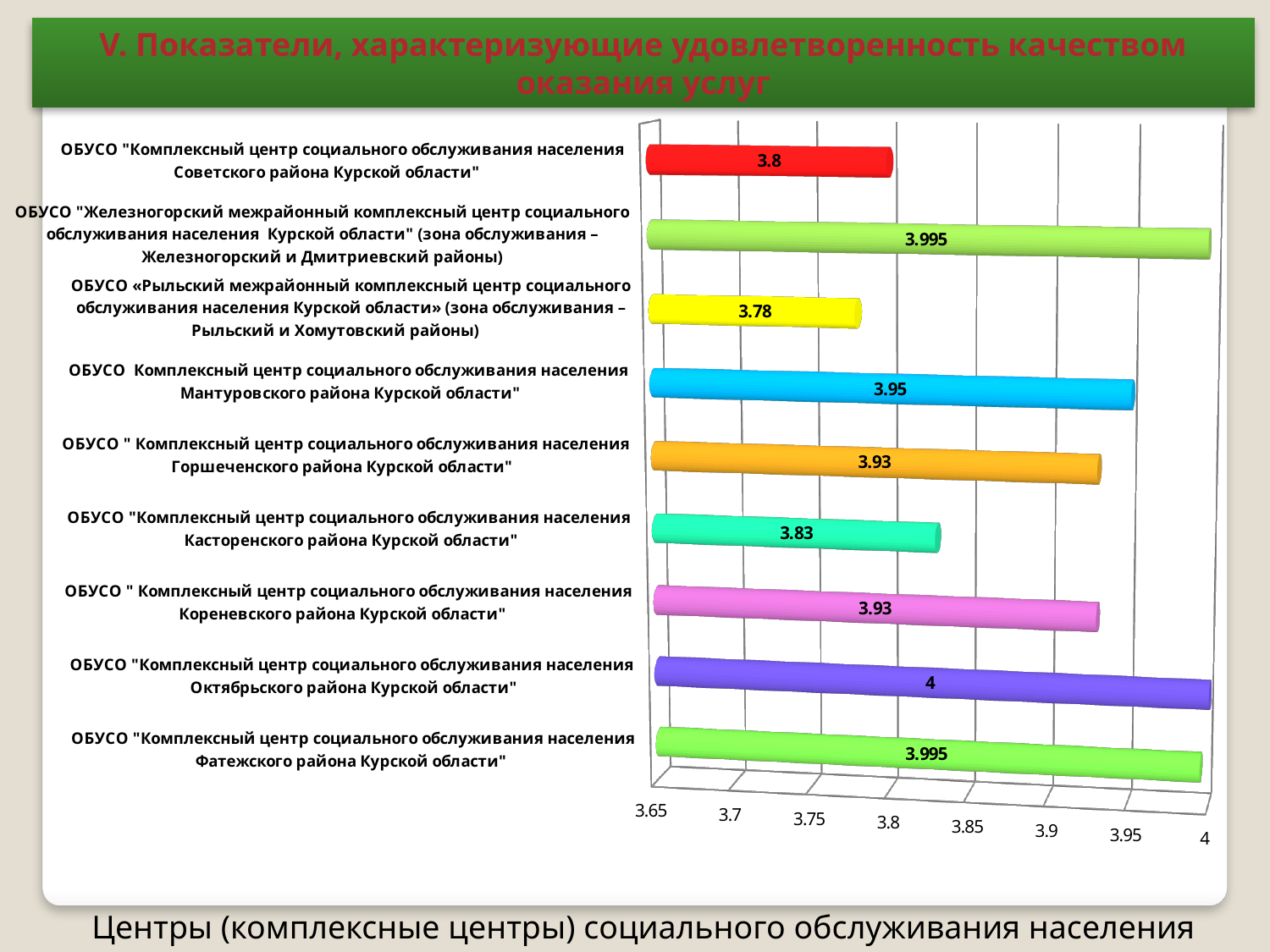
Which centre has the highest value on the chart? ОБУСО "Комплексный центр социального обслуживания населения Октябрьского района Курской области" What is the caption shown below the chart? Центры (комплексные центры) социального обслуживания населения Which centre has the lowest value on the chart? ОБУСО «Рыльский межрайонный комплексный центр социального обслуживания населения Курской области» What value is shown for ОБУСО «Рыльский межрайонный комплексный центр социального обслуживания населения Курской области»? 3.78 What is the difference between the value for the Октябрьского района centre and the value for the Советского района centre? 0.2 What value is shown for ОБУСО "Комплексный центр социального обслуживания населения Советского района Курской области"? 3.8 How many centres (bars) are shown on the chart? 9 What value is shown for ОБУСО "Комплексный центр социального обслуживания населения Касторенского района Курской области"? 3.83 What kind of chart is shown on the slide? bar chart Is the value for the Касторенского района centre greater or less than 3.9? less What value is shown for ОБУСО "Комплексный центр социального обслуживания населения Фатежского района Курской области"? 3.995 Which is larger: the value for the Мантуровского района centre or the value for the Горшеченского района centre? Мантуровского района centre